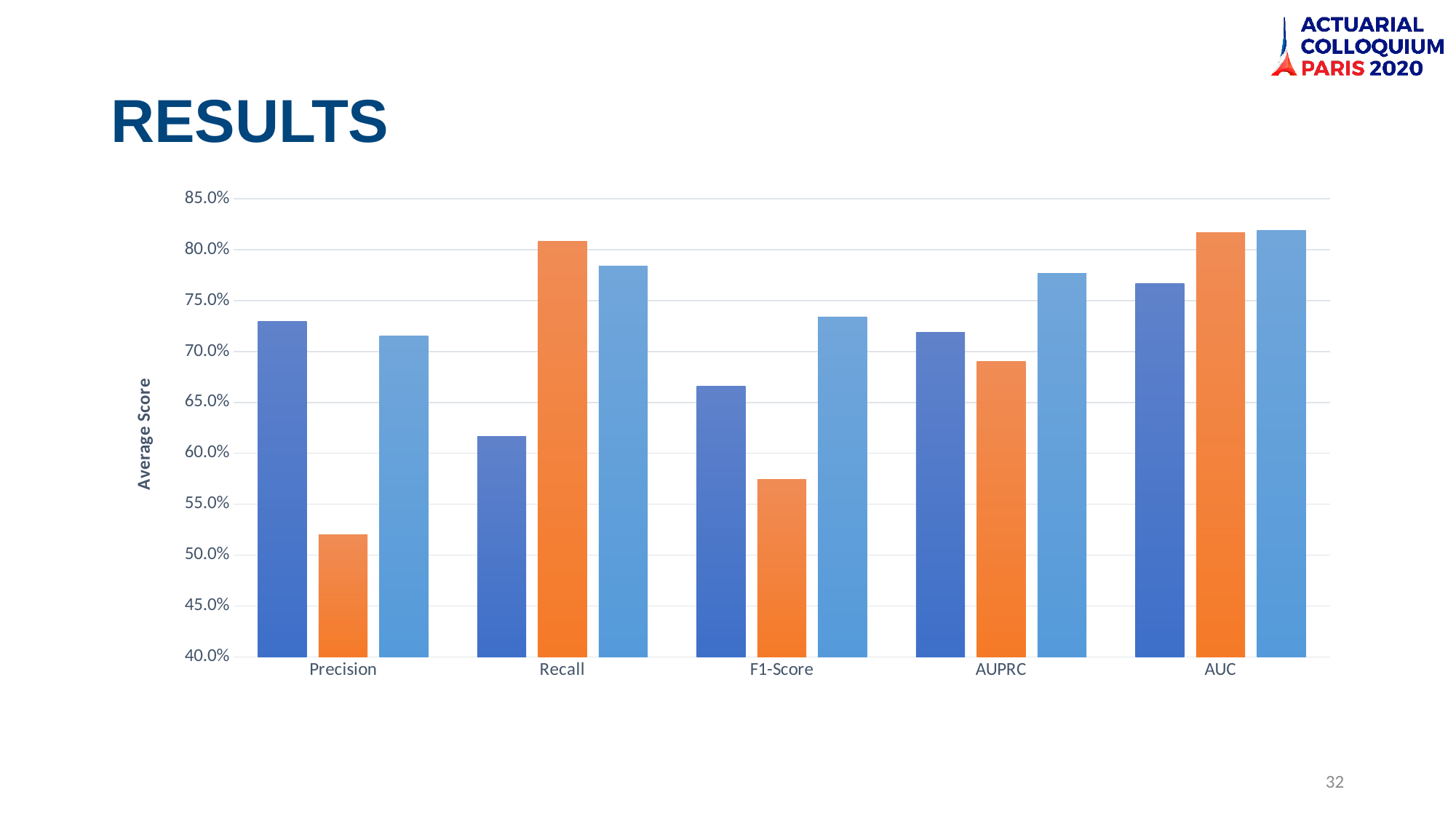
Among the dark blue bars, which category has the lowest value? Recall How many categories are shown on the x axis of the chart? 5 For Precision, which is larger: the dark blue bar or the orange bar? the dark blue bar Among the orange bars, which category has the lowest value? Precision For Recall, which is larger: the orange bar or the dark blue bar? the orange bar Among the light blue bars, which category has the highest value? AUC Which category has the lowest bar in the entire chart? Precision What kind of chart is shown on the slide? bar chart What is the label of the vertical axis of the chart? Average Score Is the light blue bar for AUPRC greater or less than 75.0%? greater Is the orange bar for Precision greater or less than 55.0%? less How many bars are plotted for each category in the chart? 3